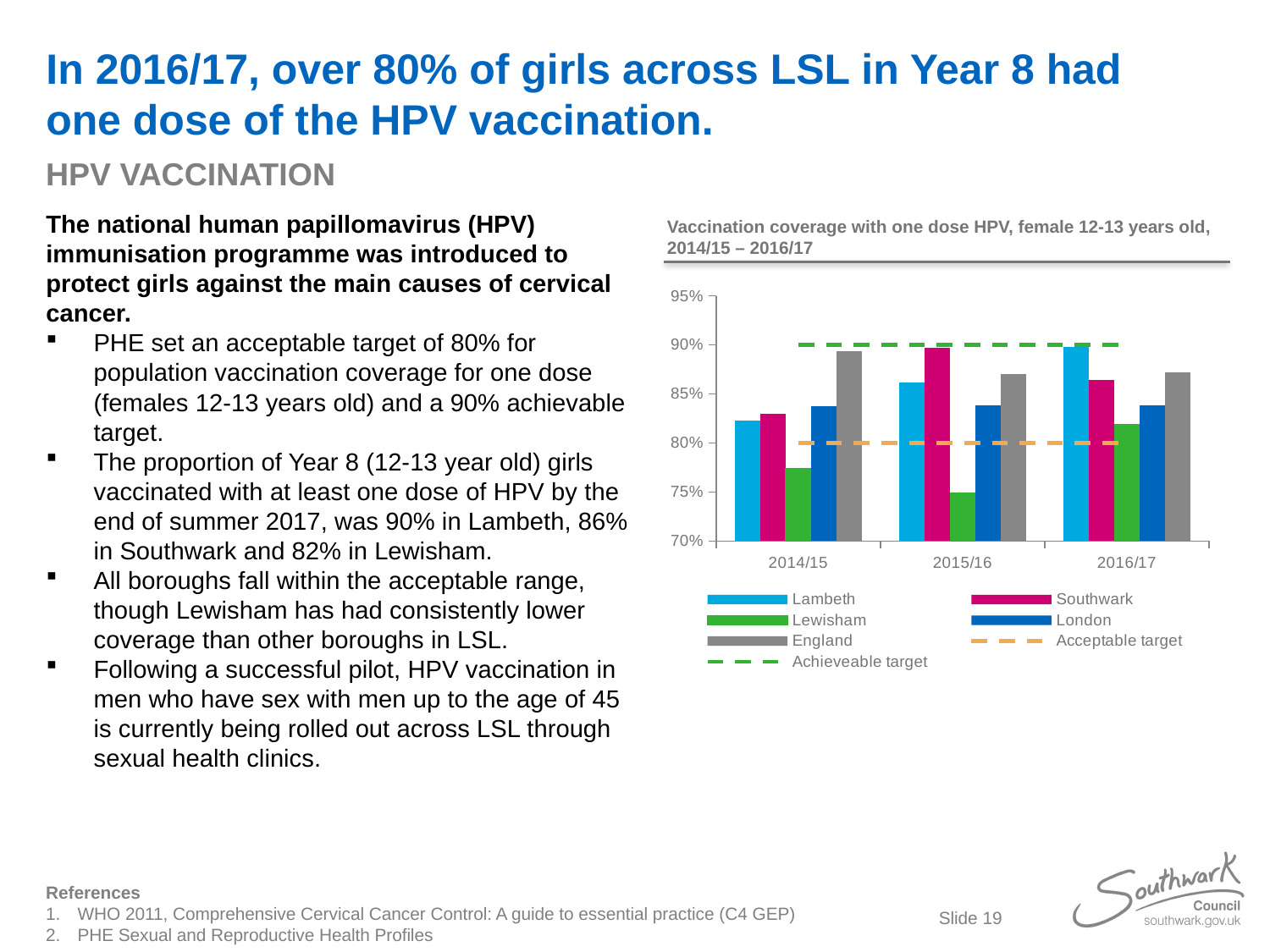
What is the title of the chart? Vaccination coverage with one dose HPV, female 12-13 years old, 2014/15 – 2016/17 At what level is the Acceptable target dashed line drawn? 80% Is the value for Lambeth in 2016/17 greater or less than 85%? greater Does Lambeth's coverage rise or fall from 2014/15 to 2016/17? rise Is the value for Lewisham in 2015/16 greater or less than 80%? less How many year categories are shown on the x axis of the chart? 3 Which area has the highest coverage in 2014/15? England Is the value for England in 2014/15 greater or less than 85%? greater At what level is the Achievable target dashed line drawn? 90% What kind of chart is shown on the slide? bar chart How many entries does the chart's legend list? 7 Which area has the lowest coverage in 2015/16? Lewisham